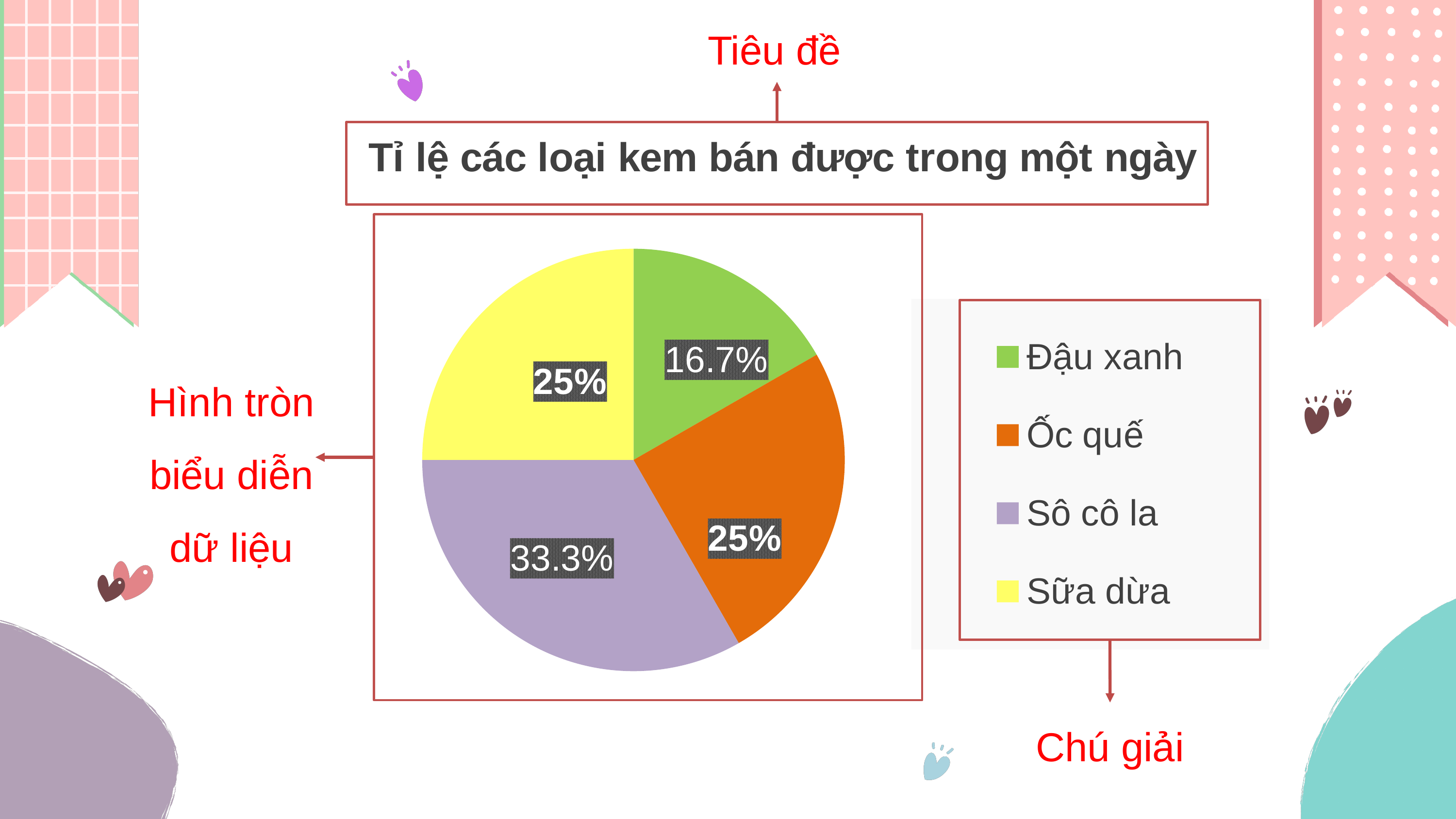
What kind of chart is shown on the slide? Pie chart What share of the pie does Sô cô la have? 33.3% What share of the pie does Đậu xanh have? 16.7% Which is larger, the share of Ốc quế or the share of Đậu xanh? Ốc quế What is the difference between the shares of Sô cô la and Đậu xanh? 16.6% Which ice cream type has the smallest share? Đậu xanh What share of the pie does Sữa dừa have? 25% How many categories does the pie chart show? 4 Which colour represents Sữa dừa in the legend? Yellow Which ice cream type has the largest share? Sô cô la What is the title of the chart? Tỉ lệ các loại kem bán được trong một ngày